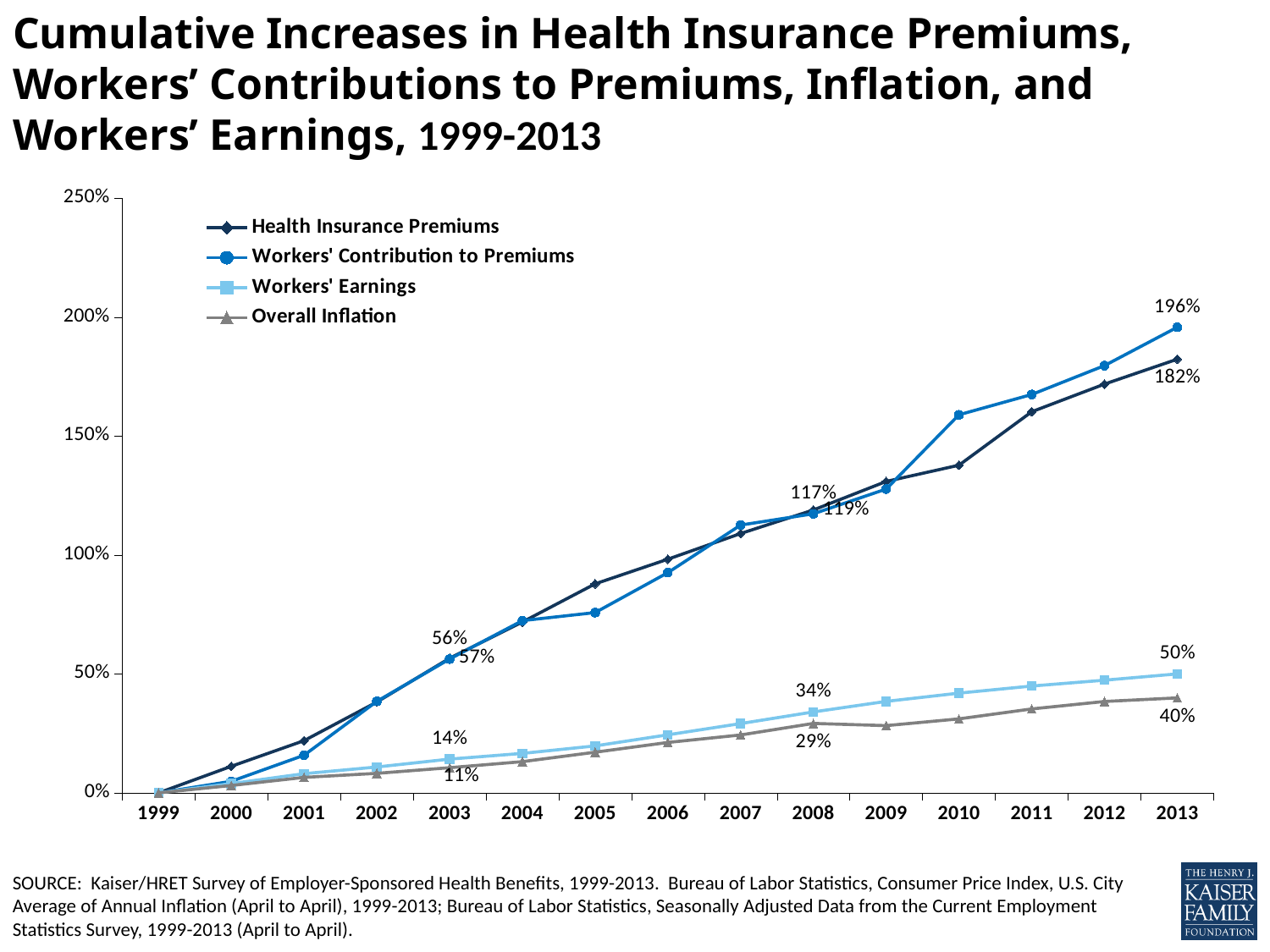
In 2010, is the value for Health Insurance Premiums greater or less than 150%? less What is the value for Health Insurance Premiums in 2013? 182% How many series does the legend list? 4 What is the value for Workers' Earnings in 2013? 50% What is the value for Workers' Earnings in 2003? 14% Which series has the lowest value in 2013? Overall Inflation What is the value for Overall Inflation in 2008? 29% How many years are shown on the x axis? 15 Which series has the highest value in 2013? Workers' Contribution to Premiums What is the value for Workers' Contribution to Premiums in 2013? 196% What kind of chart is shown on the slide? Line chart What is the difference between Workers' Earnings and Overall Inflation in 2013? 10 percentage points